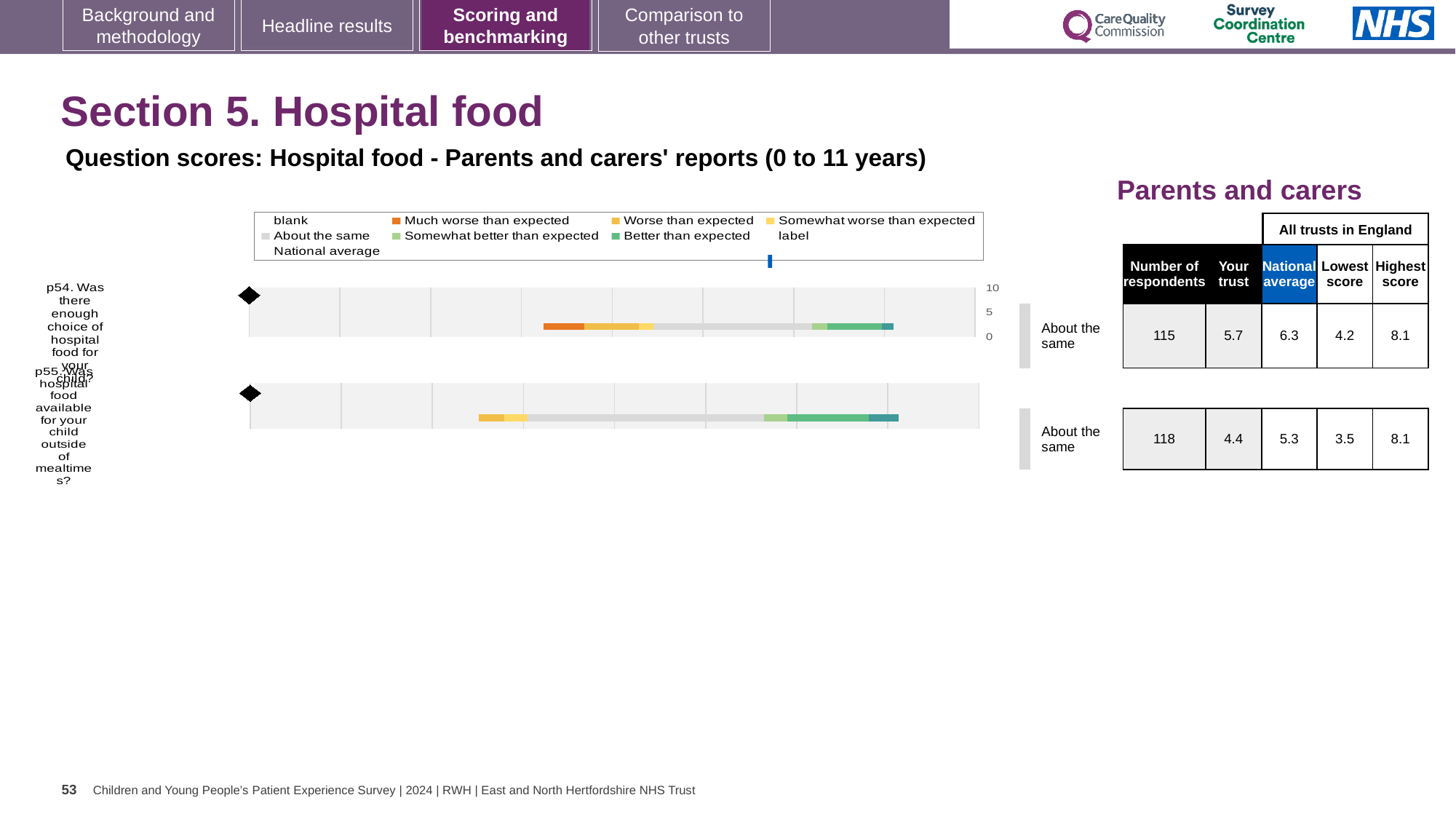
What kind of chart is used to show the question scores for hospital food? bar chart What benchmark category is given for p55 (hospital food available outside of mealtimes)? About the same Is the 'Your trust' score for p55 greater or less than 5? less What is the highest value shown on the chart's score axis? 10 What is the national average score for p55 (hospital food available outside of mealtimes)? 5.3 What is the difference between the national average and the 'Your trust' score for p54? 0.6 How many survey questions (bars) are plotted in the hospital food chart? 2 How many respondents answered question p54? 115 Which legend entry is shown with an orange colour in the chart? Much worse than expected What is the 'Your trust' score for p54 (enough choice of hospital food for your child)? 5.7 Which question has the higher 'Your trust' score, p54 or p55? p54 What is the lowest score among all trusts in England for p55? 3.5